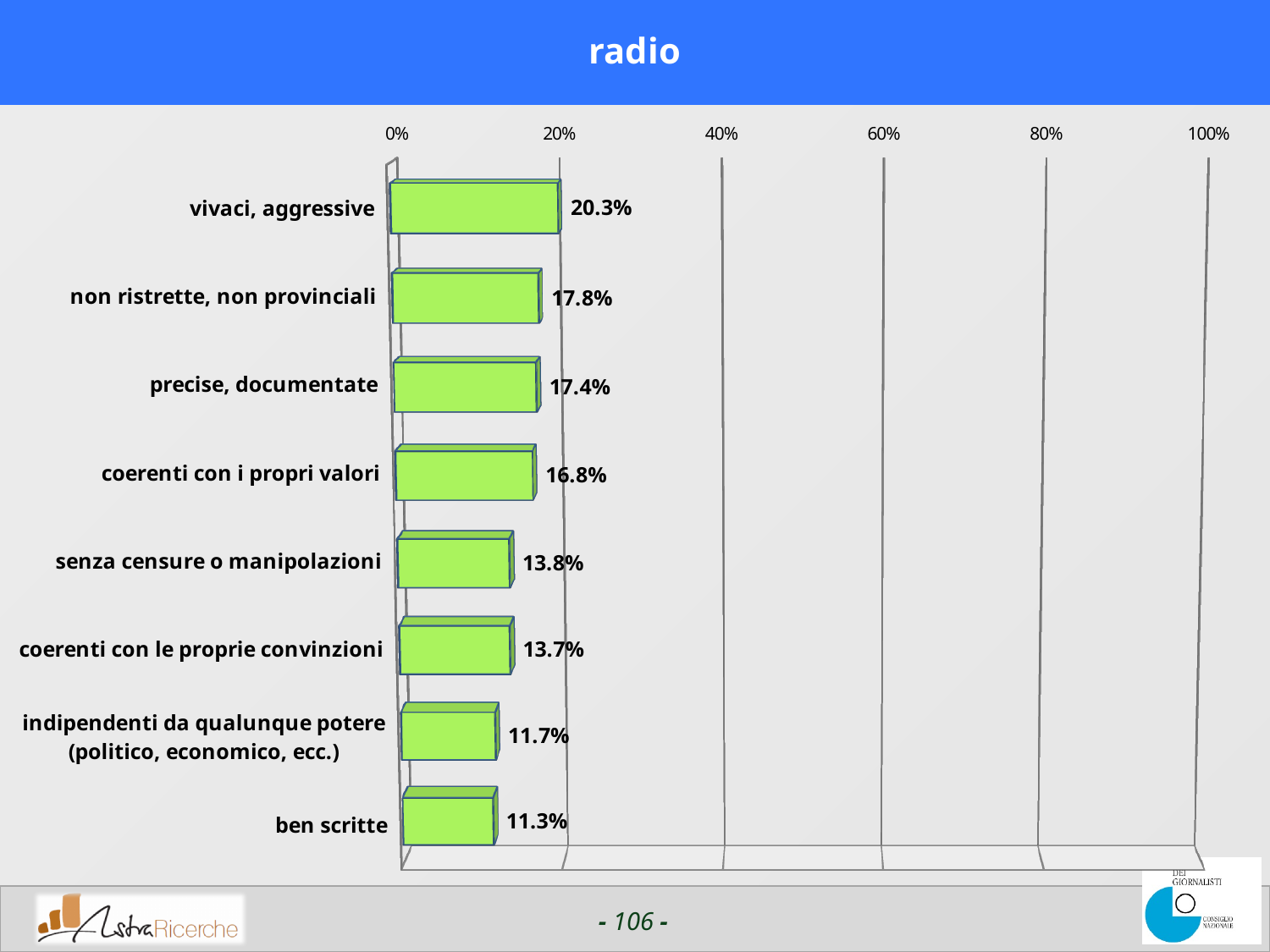
What kind of chart is shown on the slide? bar chart What is the value for "vivaci, aggressive"? 20.3% What is the value for "senza censure o manipolazioni"? 13.8% What is the value for "ben scritte"? 11.3% Which is larger, the value for "precise, documentate" or the value for "indipendenti da qualunque potere (politico, economico, ecc.)"? precise, documentate Which category has the lowest value? ben scritte How many categories are shown in the chart? 8 What is the value for "precise, documentate"? 17.4% Which category has the highest value? vivaci, aggressive What is the difference between the values for "non ristrette, non provinciali" and "coerenti con i propri valori"? 1.0% Is the value for "vivaci, aggressive" greater or less than 20%? greater What is the difference between the values for "vivaci, aggressive" and "ben scritte"? 9.0%